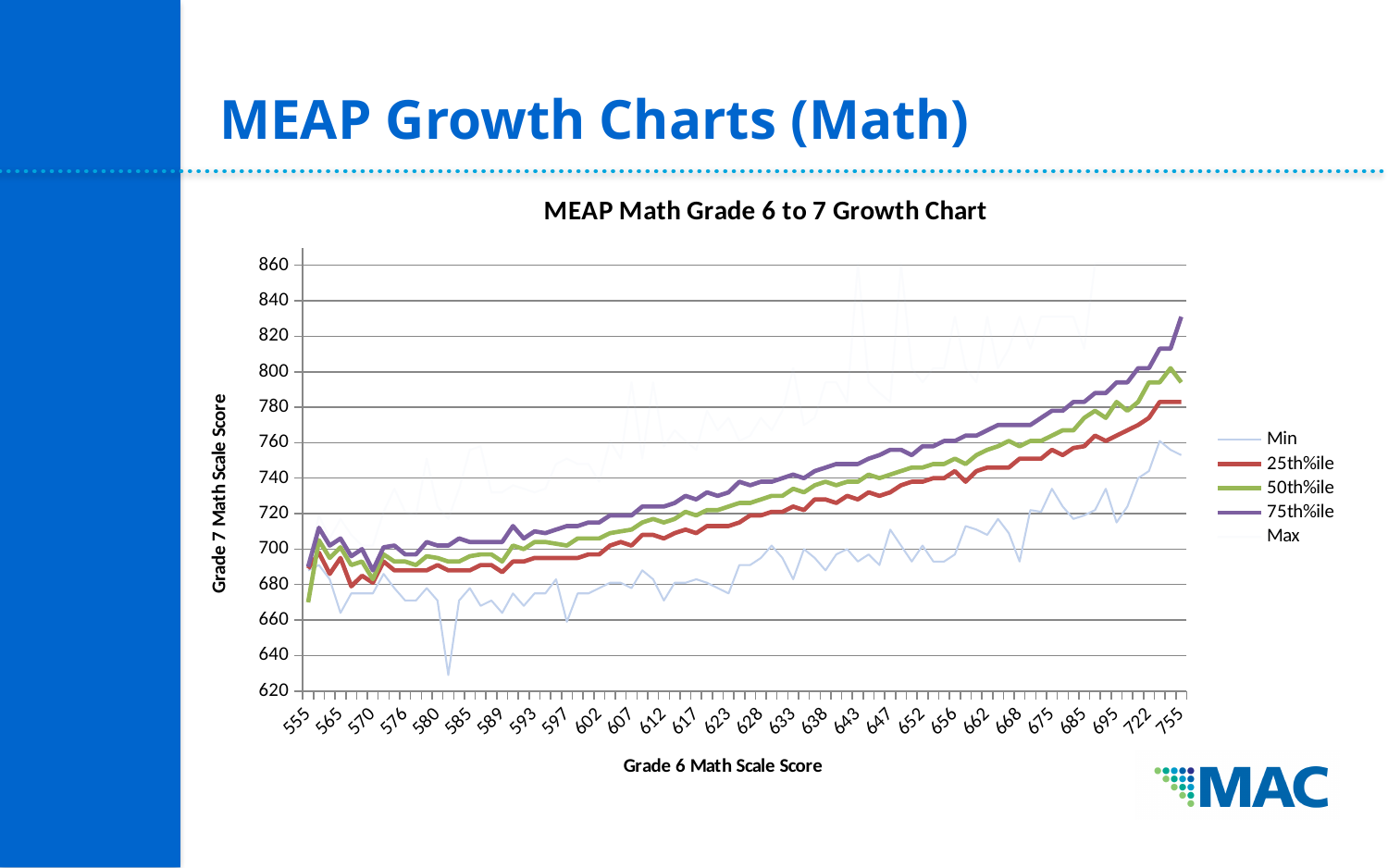
What kind of chart is shown on the slide? line chart Is the lowest point of the Min series greater or less than 660? less Is the 25th%ile value at a Grade 6 score of 755 greater or less than 760? greater Is the 50th%ile value at a Grade 6 score of 755 greater or less than 780? greater Do the 50th%ile values rise or fall as the Grade 6 Math Scale Score increases along the x axis? rise What is the title of the chart? MEAP Math Grade 6 to 7 Growth Chart How many series does the legend list? 5 At a Grade 6 score of 755, which series has the higher value, 75th%ile or 25th%ile? 75th%ile What is the label of the vertical axis? Grade 7 Math Scale Score At a Grade 6 score of 755, which series has the higher value, Min or 50th%ile? 50th%ile